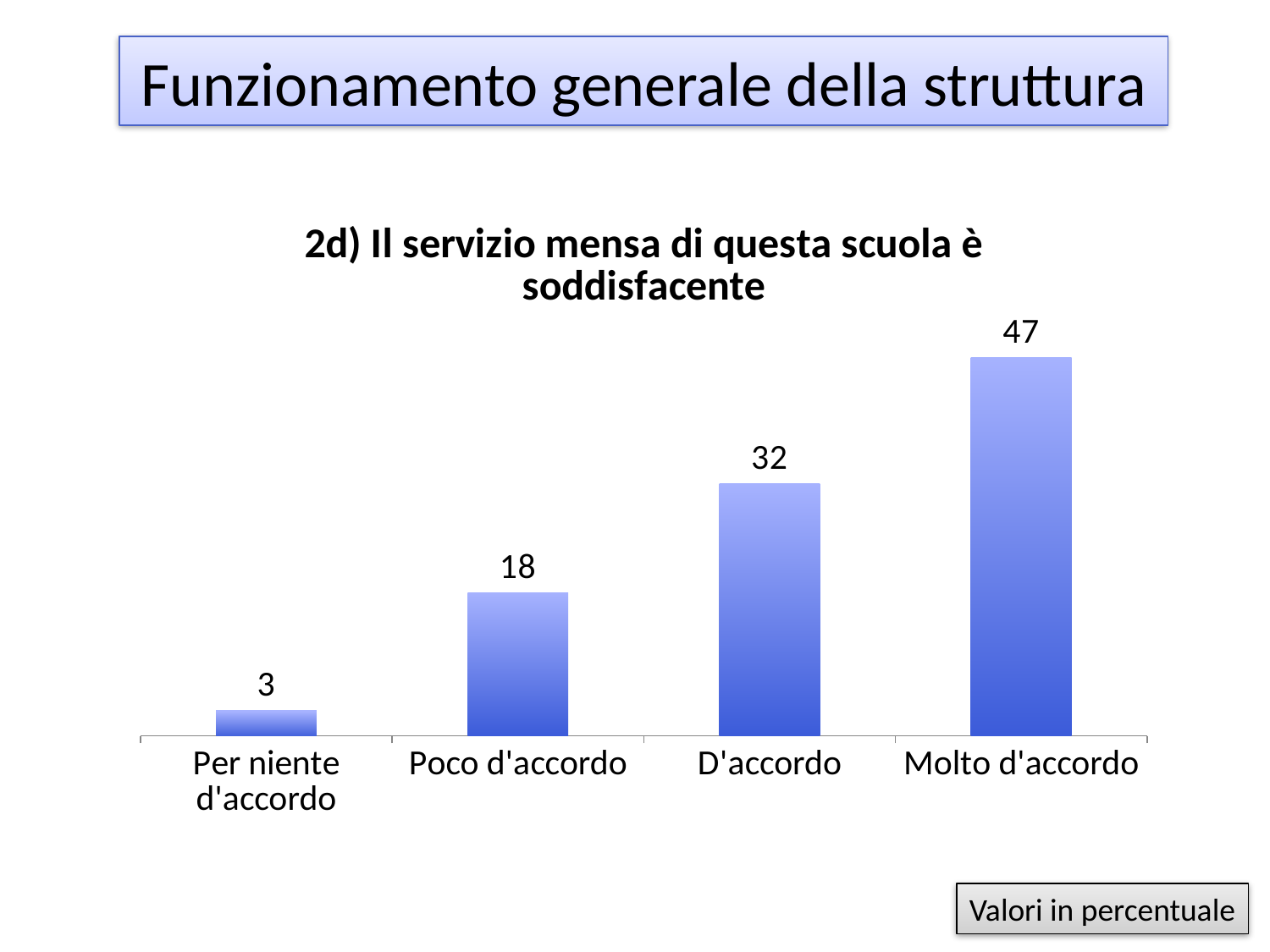
What is the value for "Per niente d'accordo"? 3 What is the value for "Poco d'accordo"? 18 What is the difference between the values for "Molto d'accordo" and "D'accordo"? 15 How many categories are shown on the x axis? 4 Which is larger, the value for "D'accordo" or the value for "Poco d'accordo"? D'accordo What is the difference between the values for "Poco d'accordo" and "Per niente d'accordo"? 15 Which category has the highest value? Molto d'accordo Which category has the lowest value? Per niente d'accordo Do the values rise or fall from left to right along the x axis? Rise What kind of chart is shown on the slide? Bar chart What is the value for "D'accordo"? 32 What is the value for "Molto d'accordo"? 47